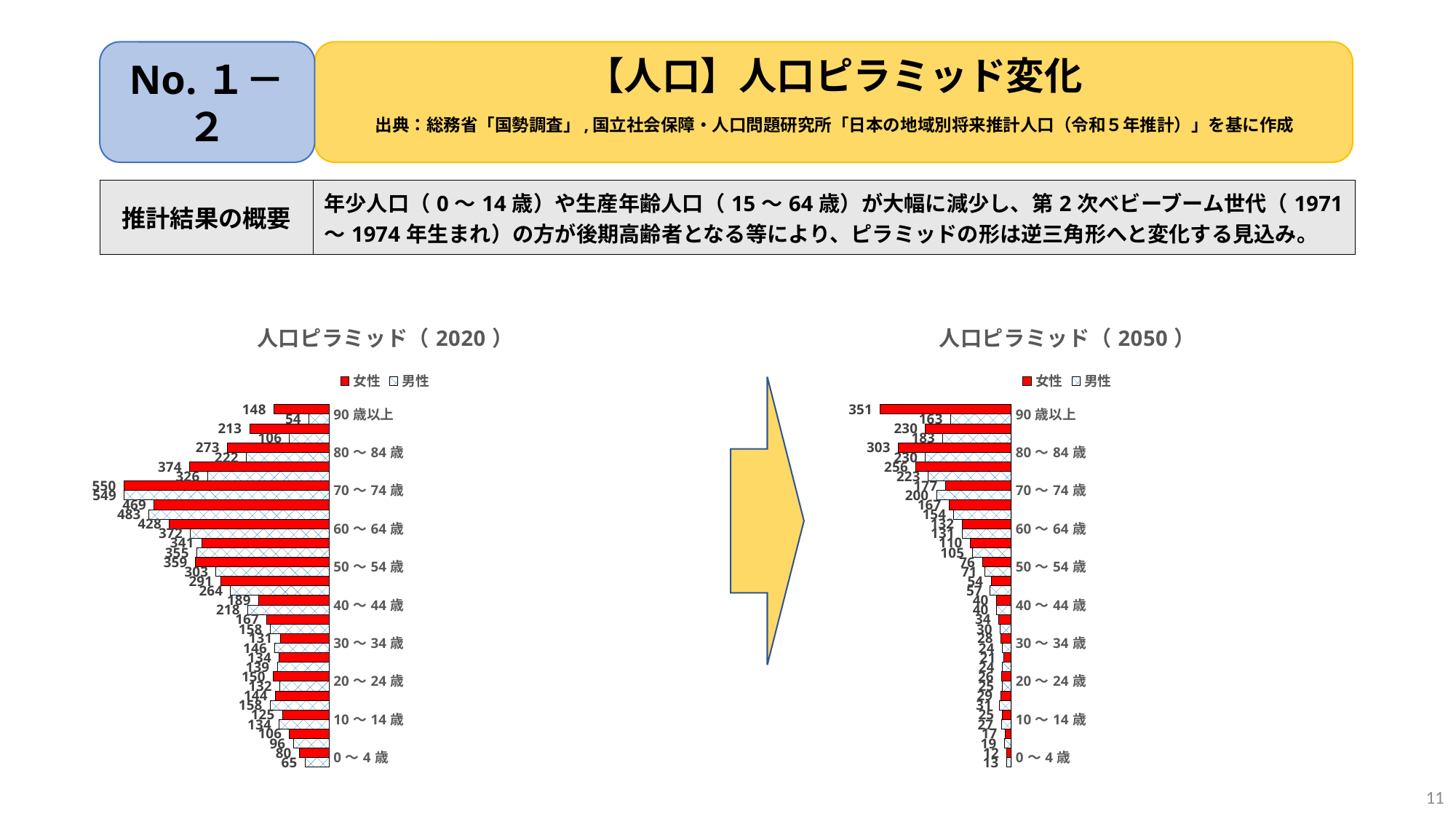
In the 人口ピラミッド（2050） chart, which age group has the highest 女性 value? 90歳以上 In the 人口ピラミッド（2020） chart, what is the value for 男性 in the 90歳以上 age group? 54 In the 人口ピラミッド（2020） chart, which colour represents 女性? Red In the 人口ピラミッド（2050） chart, what is the value for 男性 in the 0～4歳 age group? 13 What kind of chart is the 人口ピラミッド（2050） chart? Bar chart In the 人口ピラミッド（2020） chart, what is the difference between the 女性 and 男性 values in the 90歳以上 age group? 94 In the 人口ピラミッド（2020） chart, what is the value for 女性 in the 70～74歳 age group? 550 In the 人口ピラミッド（2050） chart, which is larger in the 80～84歳 age group, 女性 or 男性? 女性 How many series does the legend of the 人口ピラミッド（2020） chart list? 2 In the 人口ピラミッド（2050） chart, what is the value for 女性 in the 90歳以上 age group? 351 In the 人口ピラミッド（2020） chart, which age group has the highest 女性 value? 70～74歳 In the 人口ピラミッド（2020） chart, what is the value for 女性 in the 90歳以上 age group? 148